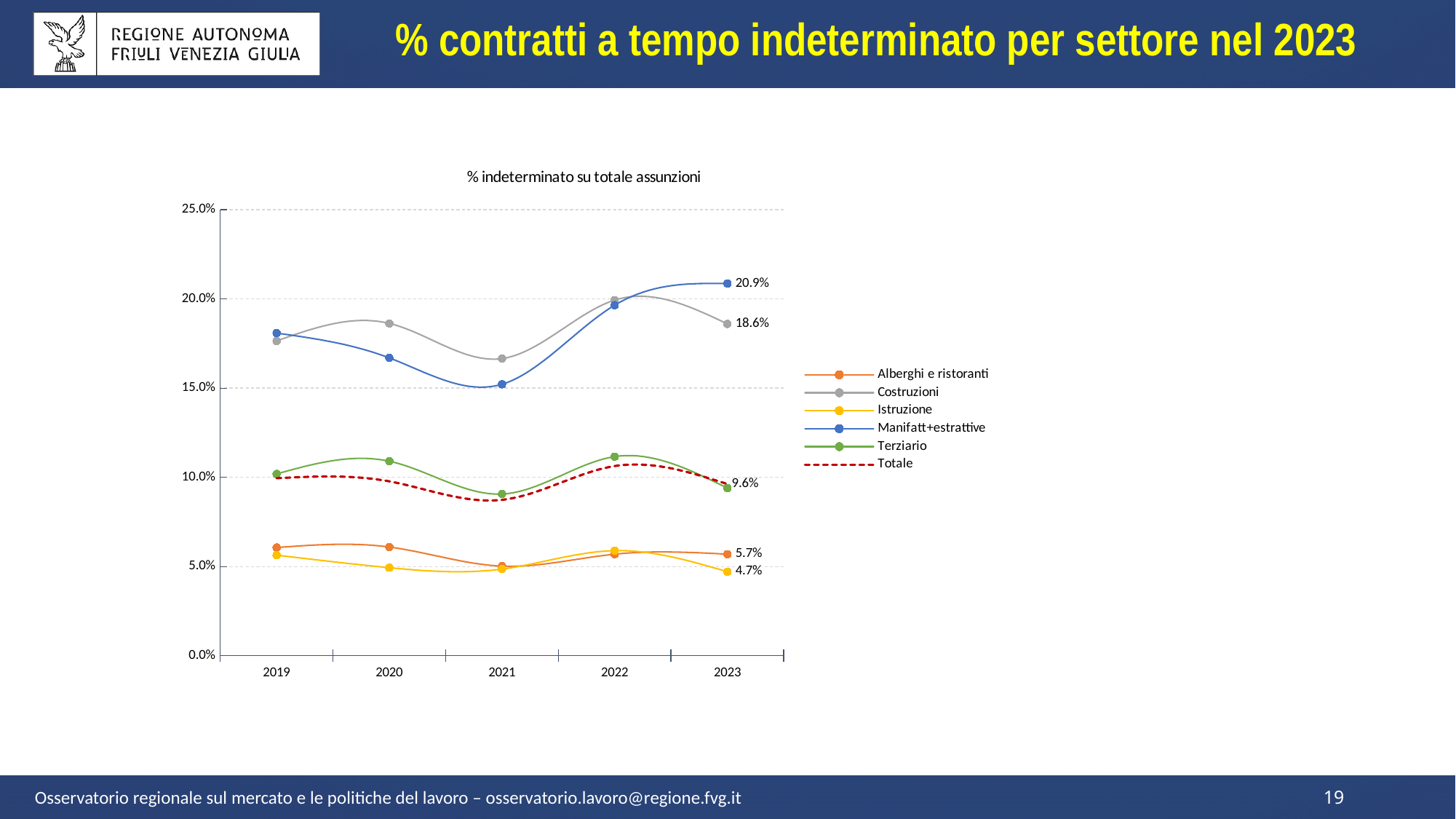
Which series has the lowest value in 2023? Istruzione What is the value for Alberghi e ristoranti in 2023? 5.7% What is the value for Istruzione in 2023? 4.7% Is the value for Costruzioni in 2021 greater or less than 15.0%? greater How many years are shown on the x axis? 5 How many series does the legend list? 6 Which series has the highest value in 2023? Manifatt+estrattive Which series is drawn with a dashed line? Totale What is the value for Manifatt+estrattive in 2023? 20.9% What is the value for Costruzioni in 2023? 18.6% What type of chart is shown on the slide? Line chart What is the difference between Manifatt+estrattive and Costruzioni in 2023? 2.3 percentage points